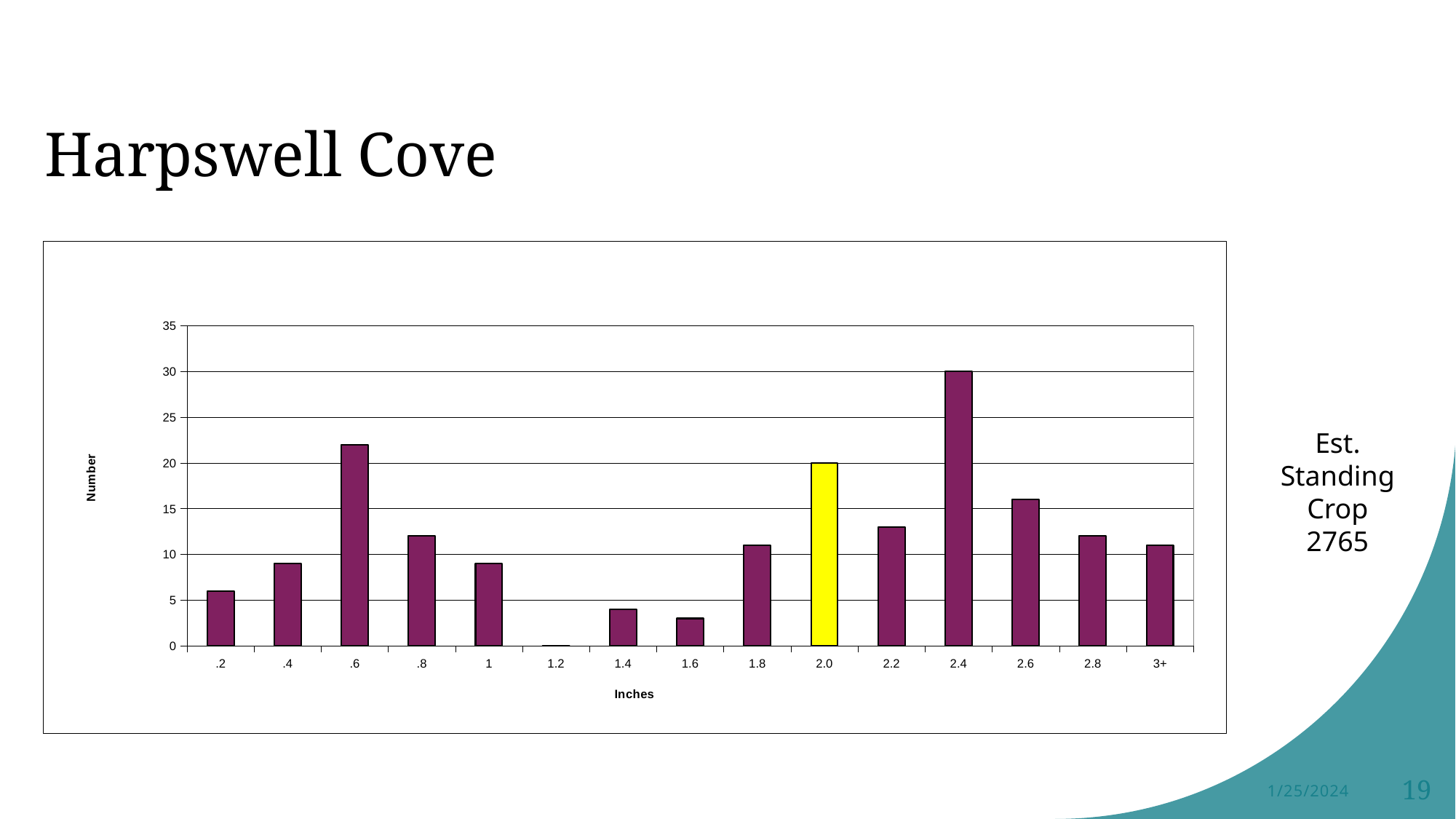
What kind of chart is shown on the slide? bar chart Is the value for .6 greater or less than 20? greater Is the value for 1.6 greater or less than 5? less Which category's bar is coloured yellow? 2.0 How many categories are shown on the x axis of the chart? 15 Which has the larger value, .4 or 1.4? .4 What is the difference between the values for 2.4 and 2.0? 10 Which category has the highest bar? 2.4 What is the value for the 2.4 category? 30 Which has the larger value, .6 or 2.6? .6 What is the value for the 2.0 category? 20 Which category has the lowest bar? 1.2